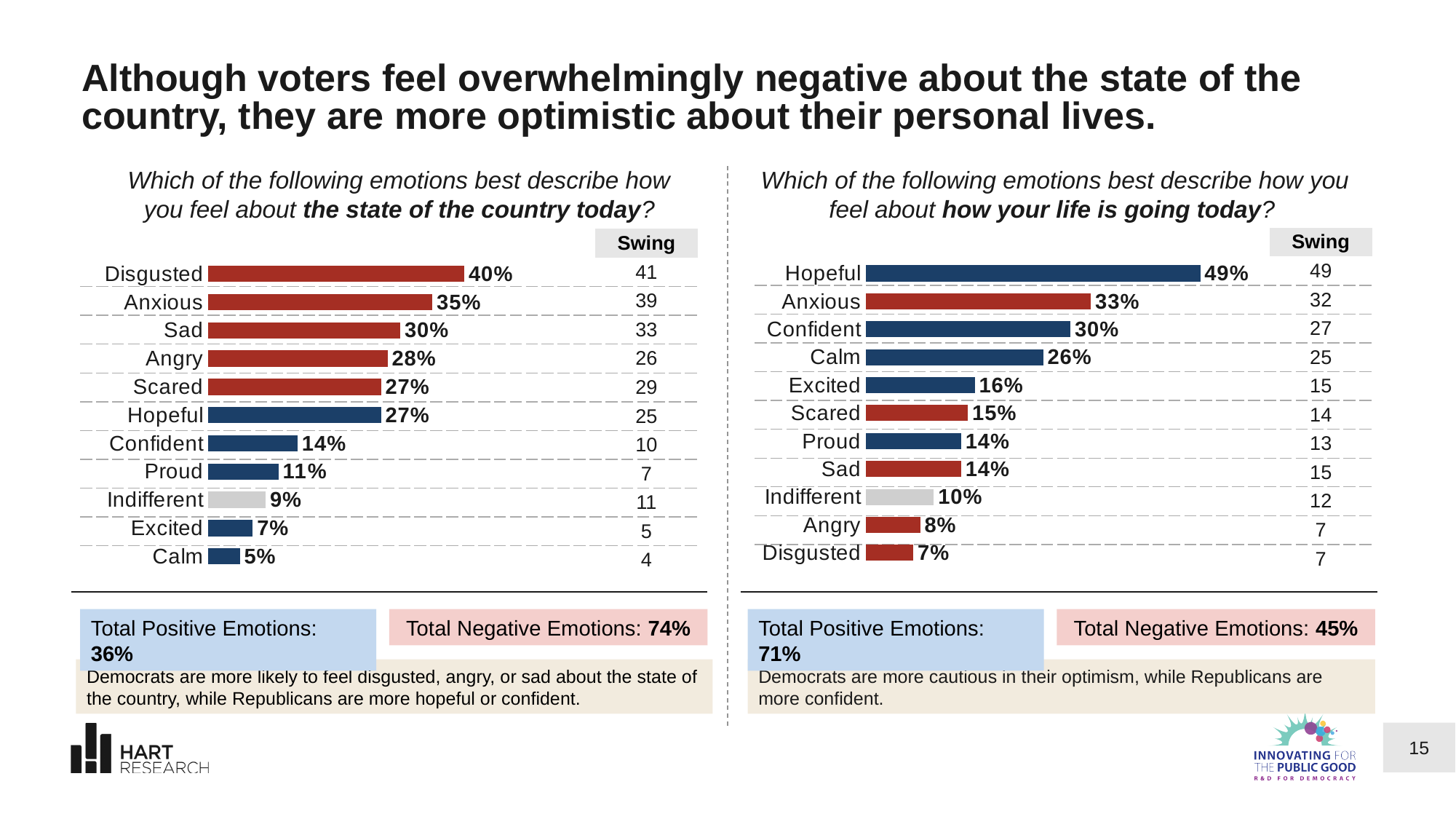
In the left chart about the state of the country today, which emotion has the lowest percentage? Calm In the right chart about how your life is going today, what percentage of voters feel Hopeful? 49% In the right chart about how your life is going today, what is the Swing value for Hopeful? 49 In the left chart about the state of the country today, what is the difference between the percentages for Disgusted and Anxious? 5% In the left chart about the state of the country today, what is the Swing value for Anxious? 39 How many emotion categories are shown in the left chart about the state of the country today? 11 In the left chart about the state of the country today, what percentage of voters feel Disgusted? 40% In the left chart about the state of the country today, which is larger: the percentage for Sad or the percentage for Angry? Sad In the right chart about how your life is going today, which is larger: the percentage for Calm or the percentage for Excited? Calm What type of chart is used on this slide? Bar chart In the right chart about how your life is going today, what is the difference between the percentages for Hopeful and Confident? 19% In the right chart about how your life is going today, which emotion has the highest percentage? Hopeful